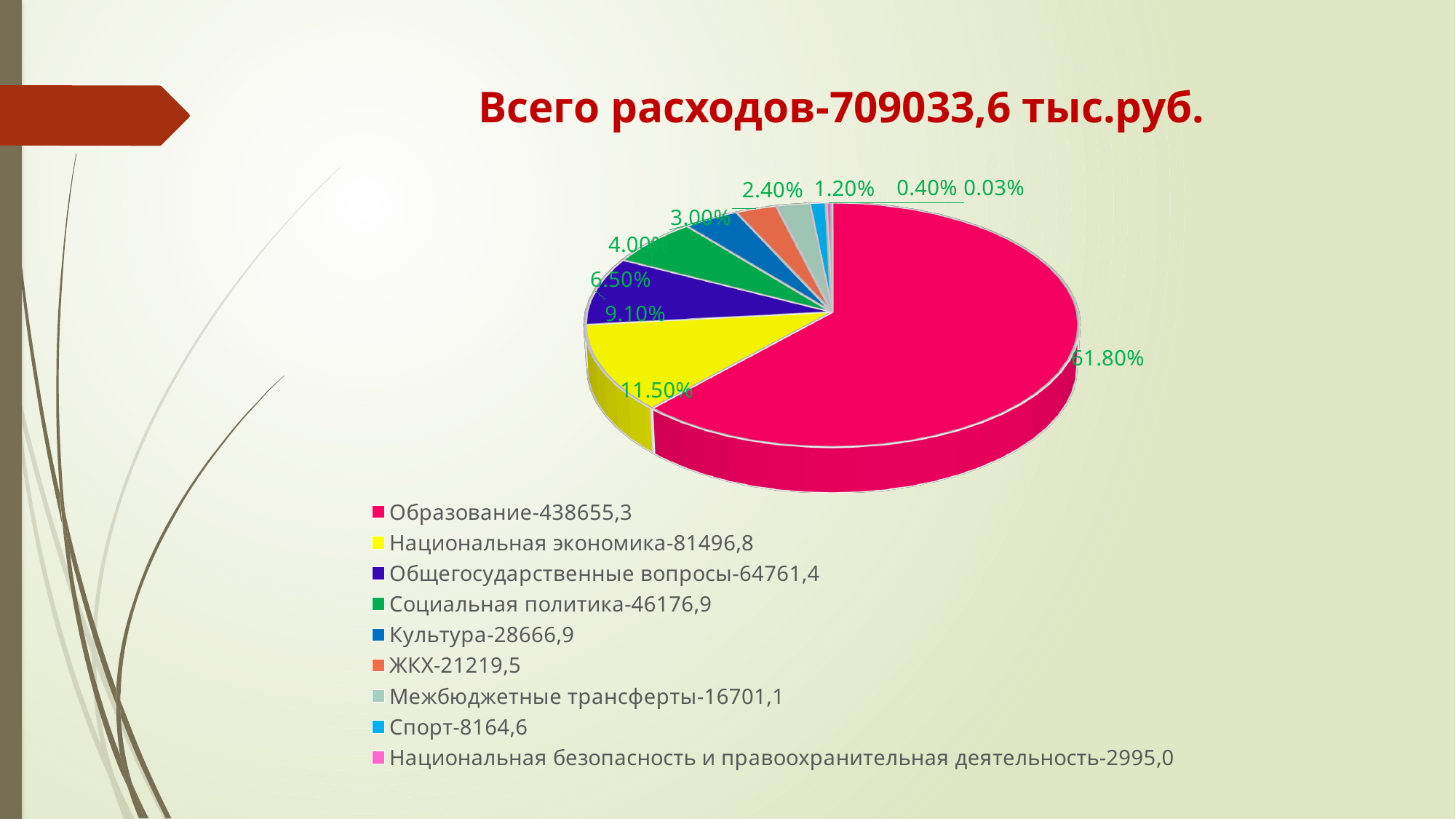
What is the title of the chart? Всего расходов-709033,6 тыс.руб. What kind of chart is shown on the slide? pie chart What share of the pie does Национальная экономика take? 11.50% What colour is the slice for Национальная экономика? yellow What value is given for Культура in the legend? 28666,9 Which category has the largest slice of the pie? Образование What share of the pie does Образование take? 61.80% What share of the pie does Социальная политика take? 6.50% Which is larger, the slice for Спорт or the slice for Межбюджетные трансферты? Межбюджетные трансферты How many entries does the chart legend list? 9 What value is given for ЖКХ in the legend? 21219,5